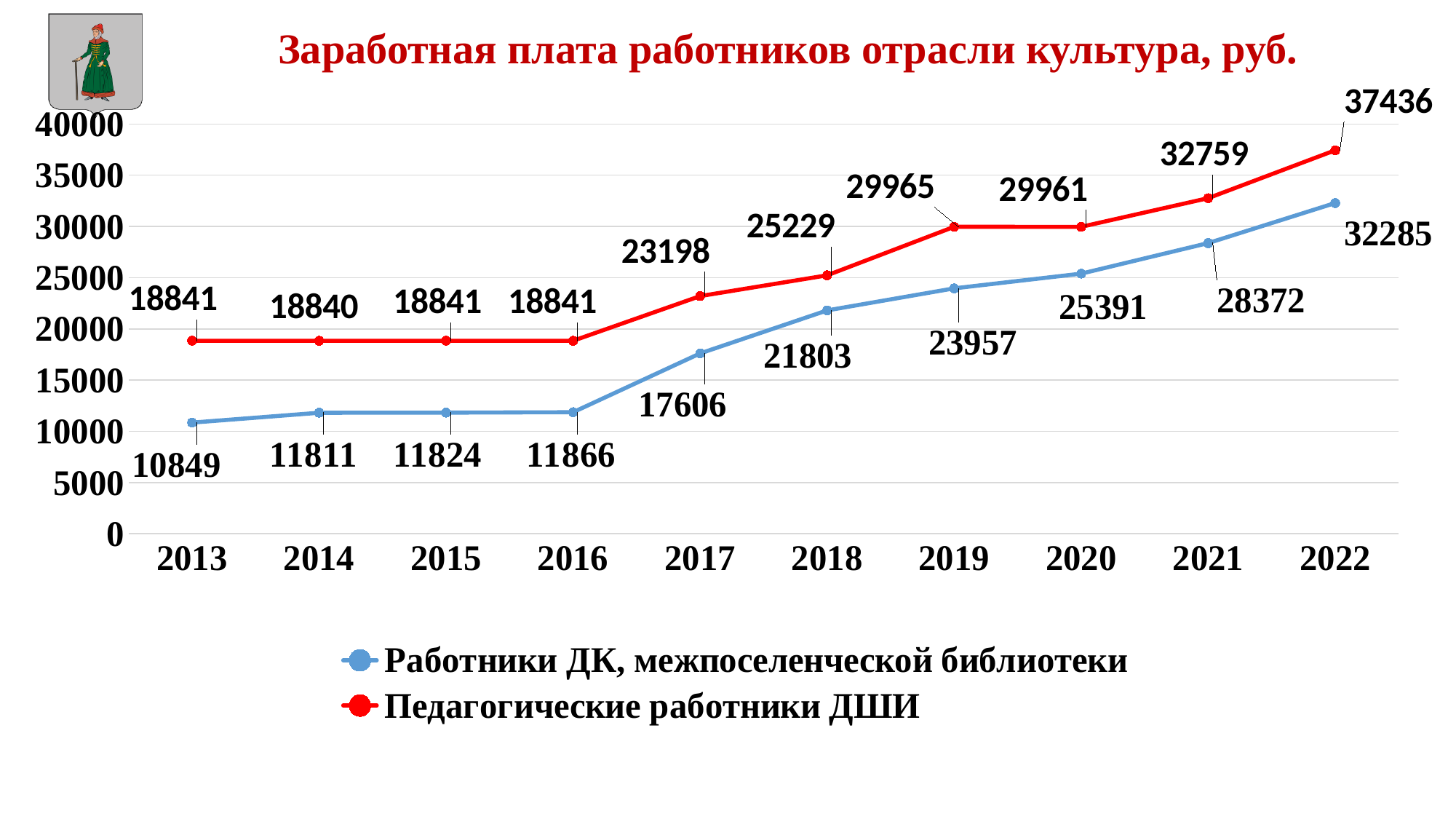
In which year is the value for Работники ДК, межпоселенческой библиотеки the lowest? 2013 What is the value for Работники ДК, межпоселенческой библиотеки in 2019? 23957 How many years are shown on the x axis? 10 Does the value for Работники ДК, межпоселенческой библиотеки rise or fall from 2016 to 2022? rise What is the difference between the two series in 2022? 5151 How many series does the legend list? 2 What is the value for Работники ДК, межпоселенческой библиотеки in 2013? 10849 Which series has the larger value in 2020? Педагогические работники ДШИ What is the value for Педагогические работники ДШИ in 2022? 37436 What type of chart is shown on the slide? line chart What is the value for Педагогические работники ДШИ in 2017? 23198 In which year is the value for Педагогические работники ДШИ the highest? 2022